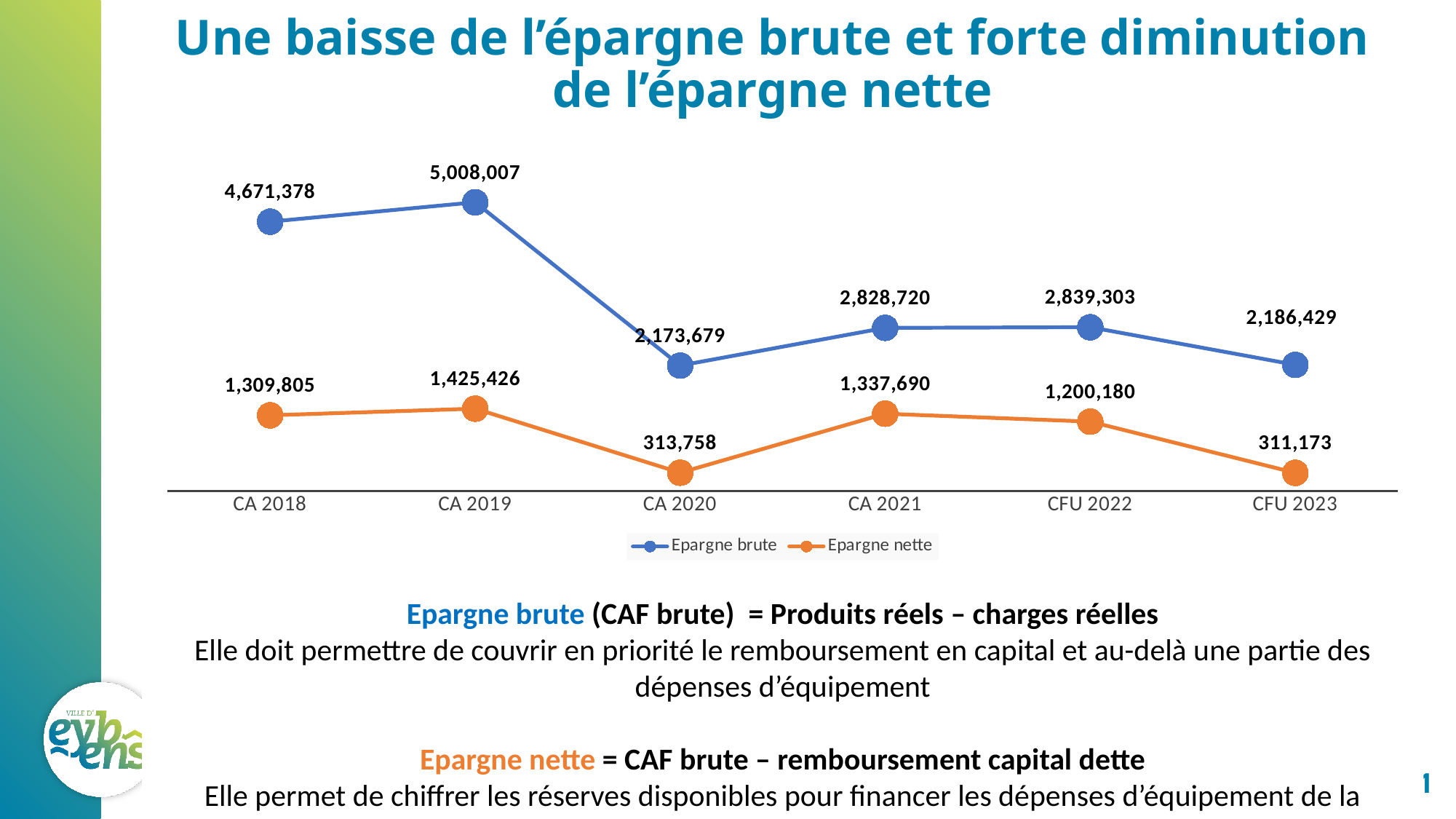
In which period is Epargne nette lowest? CFU 2023 What is the value of Epargne nette for CA 2020? 313,758 How many periods are shown on the x axis? 6 Does Epargne brute rise or fall from CA 2019 to CA 2020? Fall What is the value of Epargne brute for CA 2019? 5,008,007 What is the difference between Epargne brute in CA 2019 and CA 2018? 336,629 In which period is Epargne brute highest? CA 2019 What is the value of Epargne brute for CFU 2023? 2,186,429 Which is larger, Epargne nette in CA 2018 or in CFU 2022? CA 2018 How many series does the legend list? 2 What kind of chart is shown on the slide? Line chart What is the difference between Epargne brute and Epargne nette in CFU 2023? 1,875,256